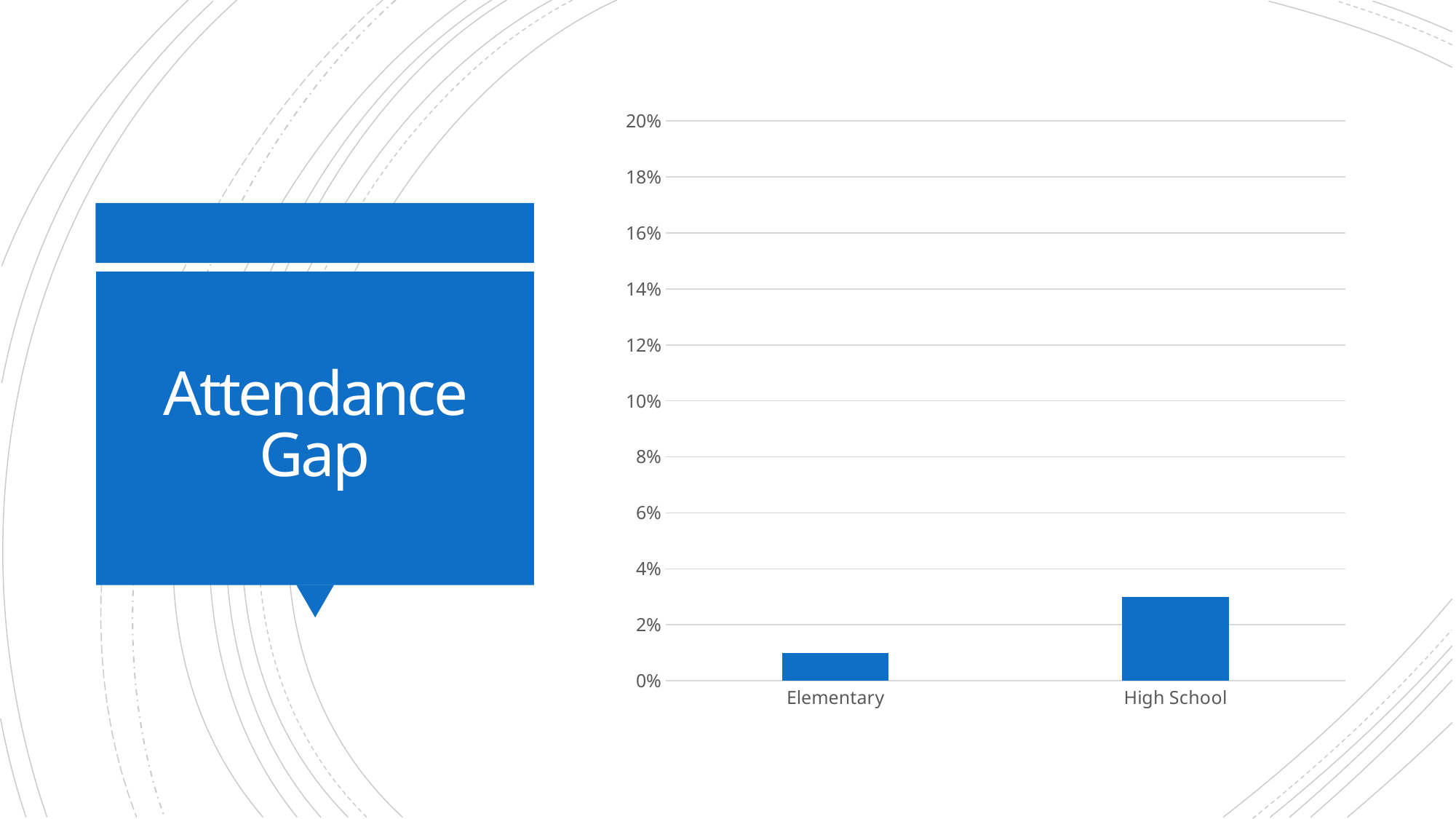
Which category has the highest value on the chart? High School Do the values rise or fall from Elementary to High School along the x axis? rise Which is larger, the value for Elementary or the value for High School? High School What kind of chart is shown on the slide? bar chart What is the title shown in the text box next to the chart? Attendance Gap How many categories are plotted on the chart? 2 Is the value for High School greater or less than 2%? greater Is the value for High School greater or less than 4%? less Which category has the lowest value on the chart? Elementary What is the highest value shown on the chart's vertical axis? 20% Is the value for Elementary greater or less than 2%? less